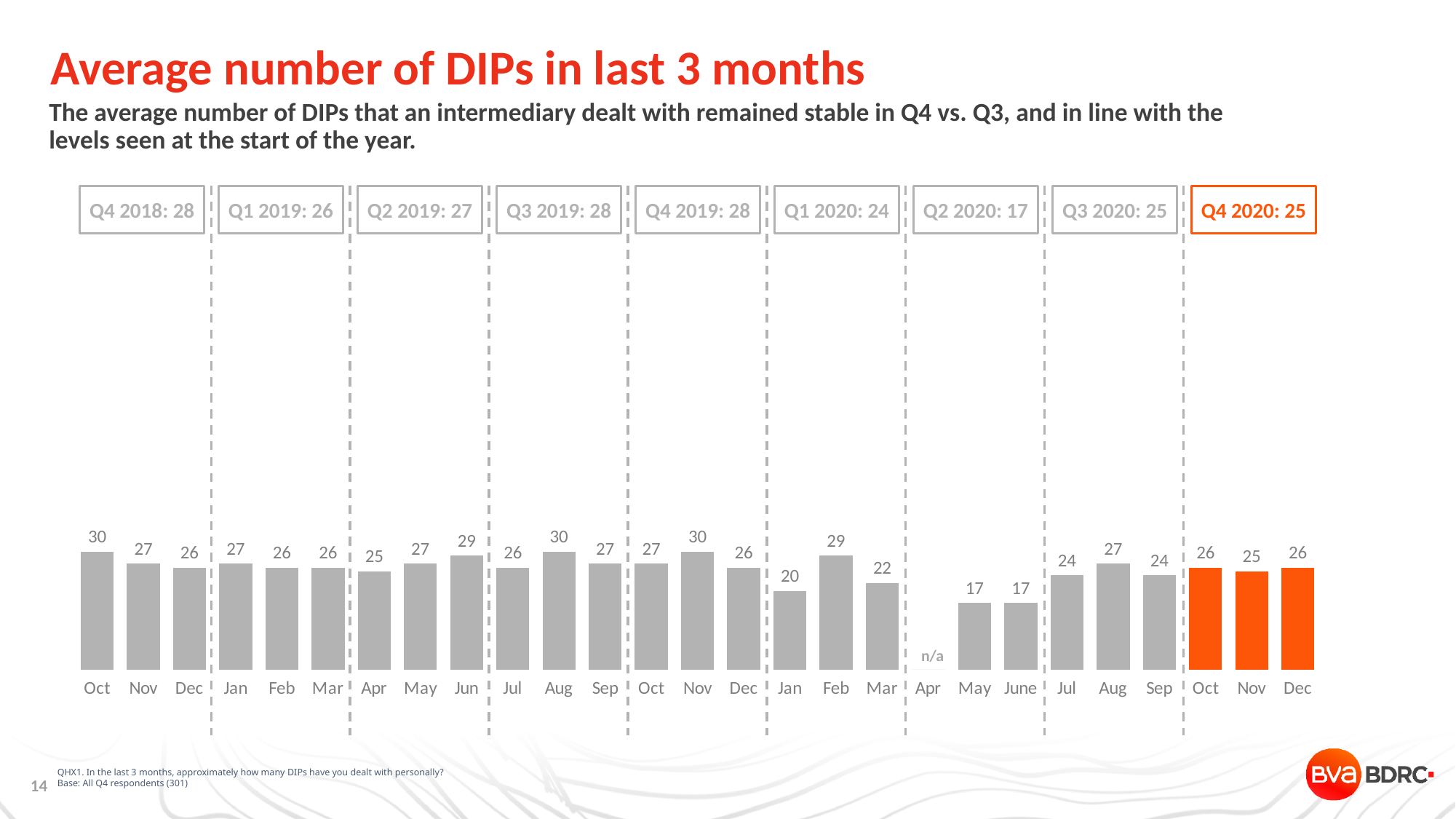
What is the value for Aug in the Q3 2019 section of the chart? 30 Which is larger: the value for Jul in Q3 2019 or the value for Jul in Q3 2020? Jul in Q3 2019 What is the lowest monthly value plotted on the chart? 17 What quarterly average is shown in the box for Q2 2020? 17 What is the value shown for Apr in the Q2 2020 section of the chart? n/a Do the values rise or fall from Jan to Mar in the Q1 2019 section? fall What is the value for Nov in the Q4 2020 section of the chart? 25 What is the difference between the Feb and Jan values in the Q1 2020 section? 9 How many month labels are shown along the x axis of the chart? 27 What is the value for Feb in the Q1 2020 section of the chart? 29 Which quarter's bars are coloured orange on the chart? Q4 2020 What type of chart is shown on the slide? bar chart